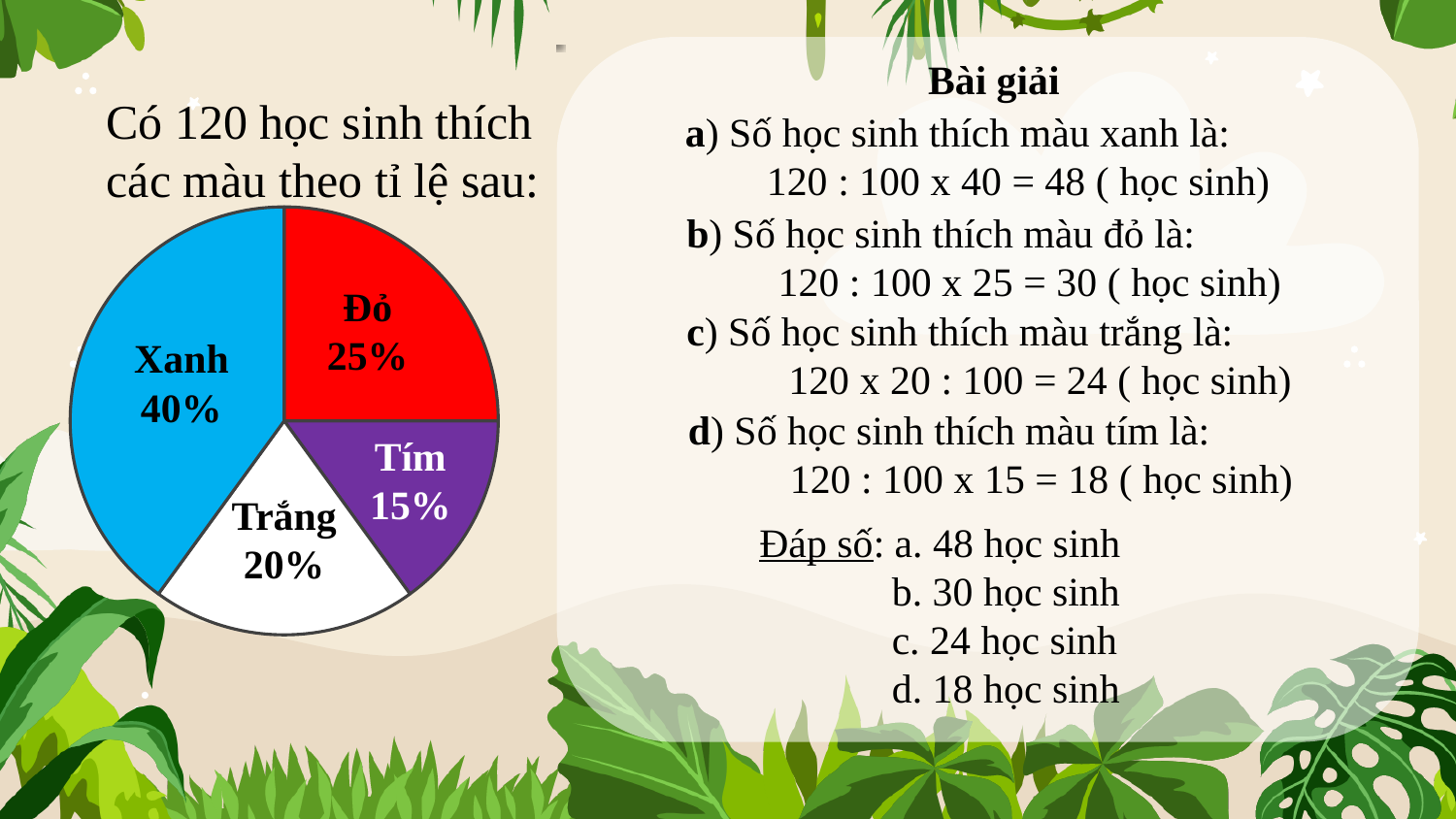
What percentage of the pie chart is labelled Trắng? 20% What percentage of the pie chart is labelled Xanh? 40% How many slices does the pie chart have? 4 What is the difference in percentage points between the Trắng slice and the Tím slice? 5% What percentage of the pie chart is labelled Đỏ? 25% Which colour has the smallest share of the pie chart? Tím Which slice is larger, Trắng or Tím? Trắng What is the difference in percentage points between the Xanh slice and the Đỏ slice? 15% What percentage of the pie chart is labelled Tím? 15% What colour is the slice labelled Tím drawn in? purple Which colour has the largest share of the pie chart? Xanh What kind of chart is shown on the slide? pie chart